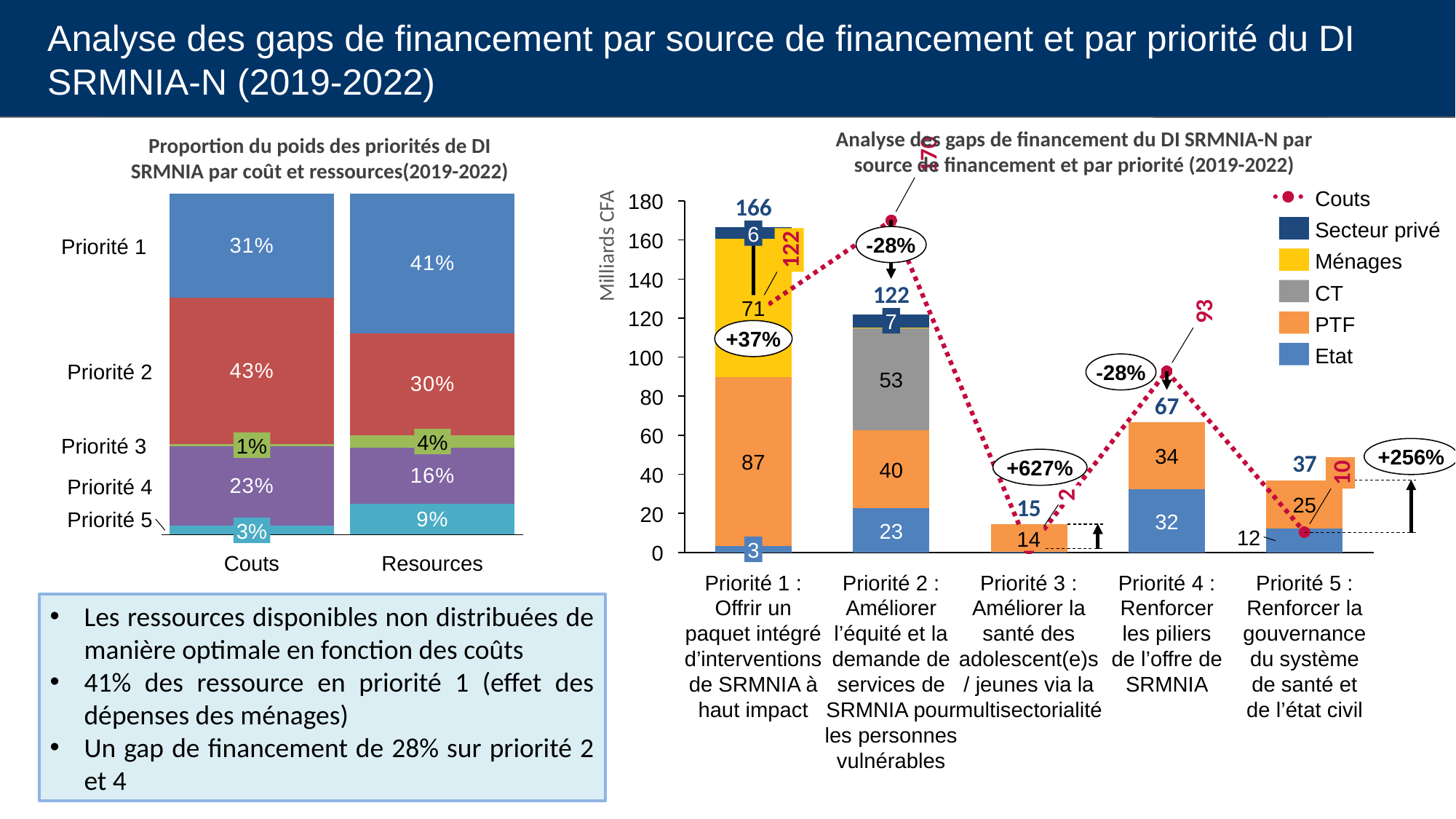
In the right chart 'Analyse des gaps de financement du DI SRMNIA-N par source de financement et par priorité', what is the Couts value for Priorité 4? 93 What kind of chart is the right chart 'Analyse des gaps de financement du DI SRMNIA-N par source de financement et par priorité'? Stacked bar chart with a line In the left chart 'Proportion du poids des priorités de DI SRMNIA par coût et ressources', what is the share of Priorité 1 in the Couts bar? 31% In the right chart 'Analyse des gaps de financement du DI SRMNIA-N par source de financement et par priorité', what is the CT value for Priorité 2? 53 In the right chart 'Analyse des gaps de financement du DI SRMNIA-N par source de financement et par priorité', what is the PTF value for Priorité 1? 87 In the left chart 'Proportion du poids des priorités de DI SRMNIA par coût et ressources', what is the difference between the Resources share and the Couts share for Priorité 5? 6% In the right chart 'Analyse des gaps de financement du DI SRMNIA-N par source de financement et par priorité', how many entries does the legend list? 6 In the left chart 'Proportion du poids des priorités de DI SRMNIA par coût et ressources', what is the share of Priorité 2 in the Resources bar? 30% In the left chart 'Proportion du poids des priorités de DI SRMNIA par coût et ressources', which priority has the largest share of the Couts bar? Priorité 2 In the right chart 'Analyse des gaps de financement du DI SRMNIA-N par source de financement et par priorité', what is the total of the stacked bar for Priorité 2? 122 In the right chart 'Analyse des gaps de financement du DI SRMNIA-N par source de financement et par priorité', is the Etat value for Priorité 4 larger or smaller than the PTF value for Priorité 4? smaller In the right chart 'Analyse des gaps de financement du DI SRMNIA-N par source de financement et par priorité', which priority has the lowest stacked bar total? Priorité 3